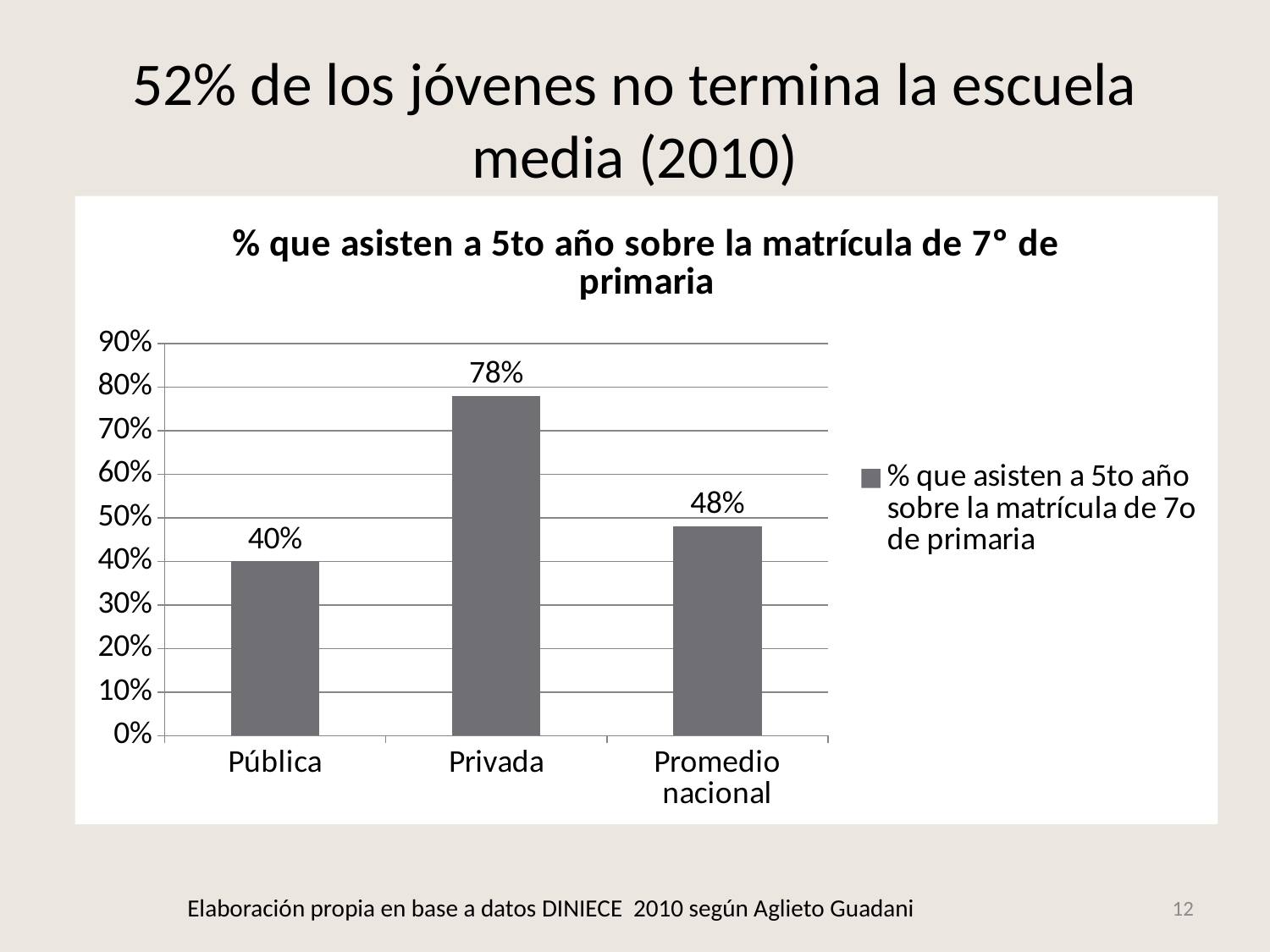
What is the value for Pública? 40% Which category has the highest value? Privada What is the difference between the values for Promedio nacional and Pública? 8% What is the value for Promedio nacional? 48% What kind of chart is shown on the slide? bar chart Which category has the lowest value? Pública Which is larger, the value for Privada or the value for Promedio nacional? Privada What is the value for Privada? 78% How many categories are shown on the x axis? 3 What is the title of the chart? % que asisten a 5to año sobre la matrícula de 7º de primaria What is the difference between the values for Privada and Pública? 38% Is the value for Privada greater or less than 70%? greater